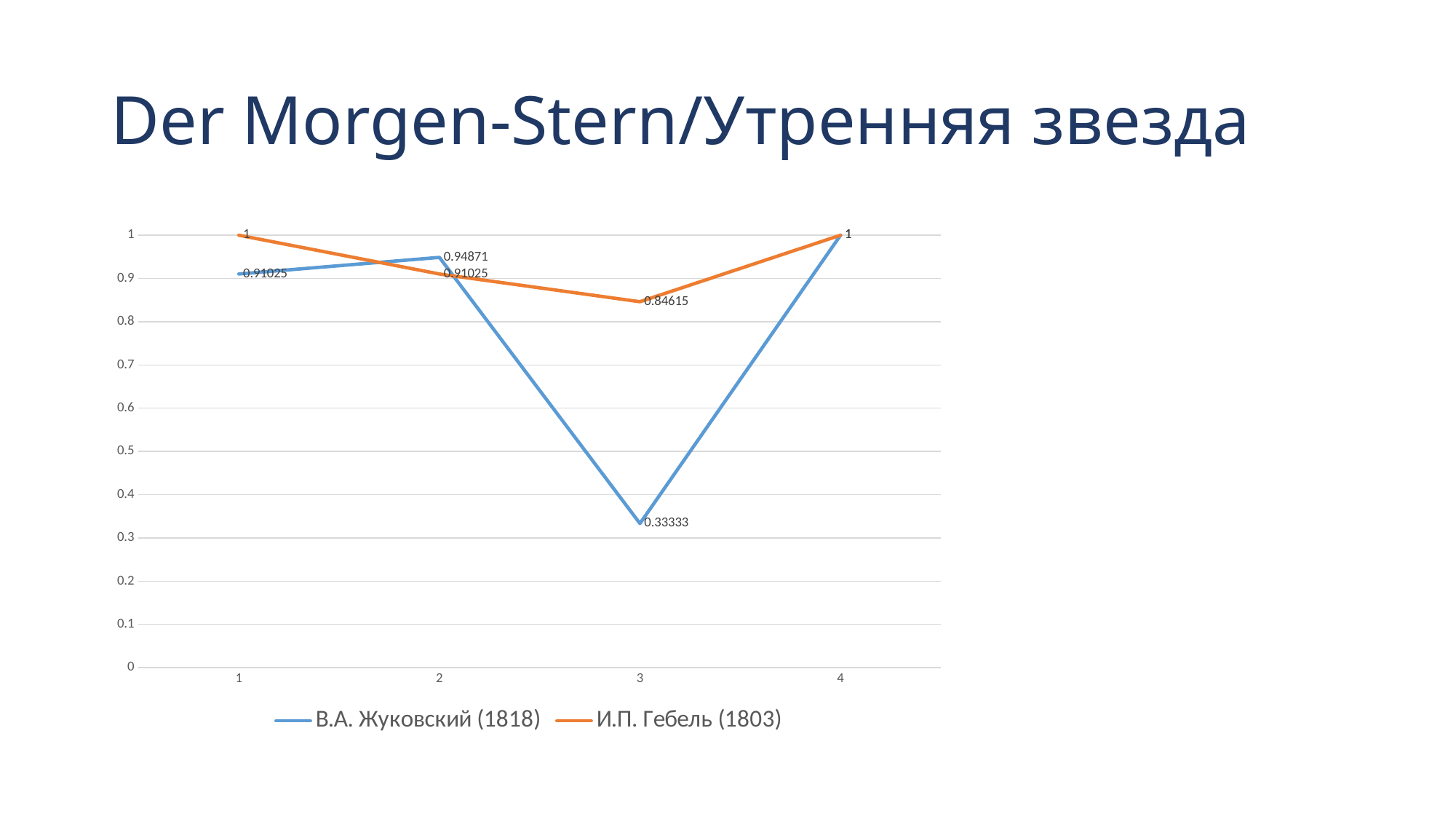
What kind of chart is shown on the slide? line chart Is the value for В.А. Жуковский (1818) at point 3 greater or less than 0.5? less What is the value for И.П. Гебель (1803) at point 3? 0.84615 What is the value for В.А. Жуковский (1818) at point 2? 0.94871 At which point does И.П. Гебель (1803) have its lowest value? 3 At which point does В.А. Жуковский (1818) have its lowest value? 3 What is the value for И.П. Гебель (1803) at point 1? 1 How many series does the legend list? 2 What is the difference between the values of И.П. Гебель (1803) and В.А. Жуковский (1818) at point 3? 0.51282 What is the value for В.А. Жуковский (1818) at point 3? 0.33333 Which series has the larger value at point 3, В.А. Жуковский (1818) or И.П. Гебель (1803)? И.П. Гебель (1803) How many points are plotted along the x axis for each series? 4